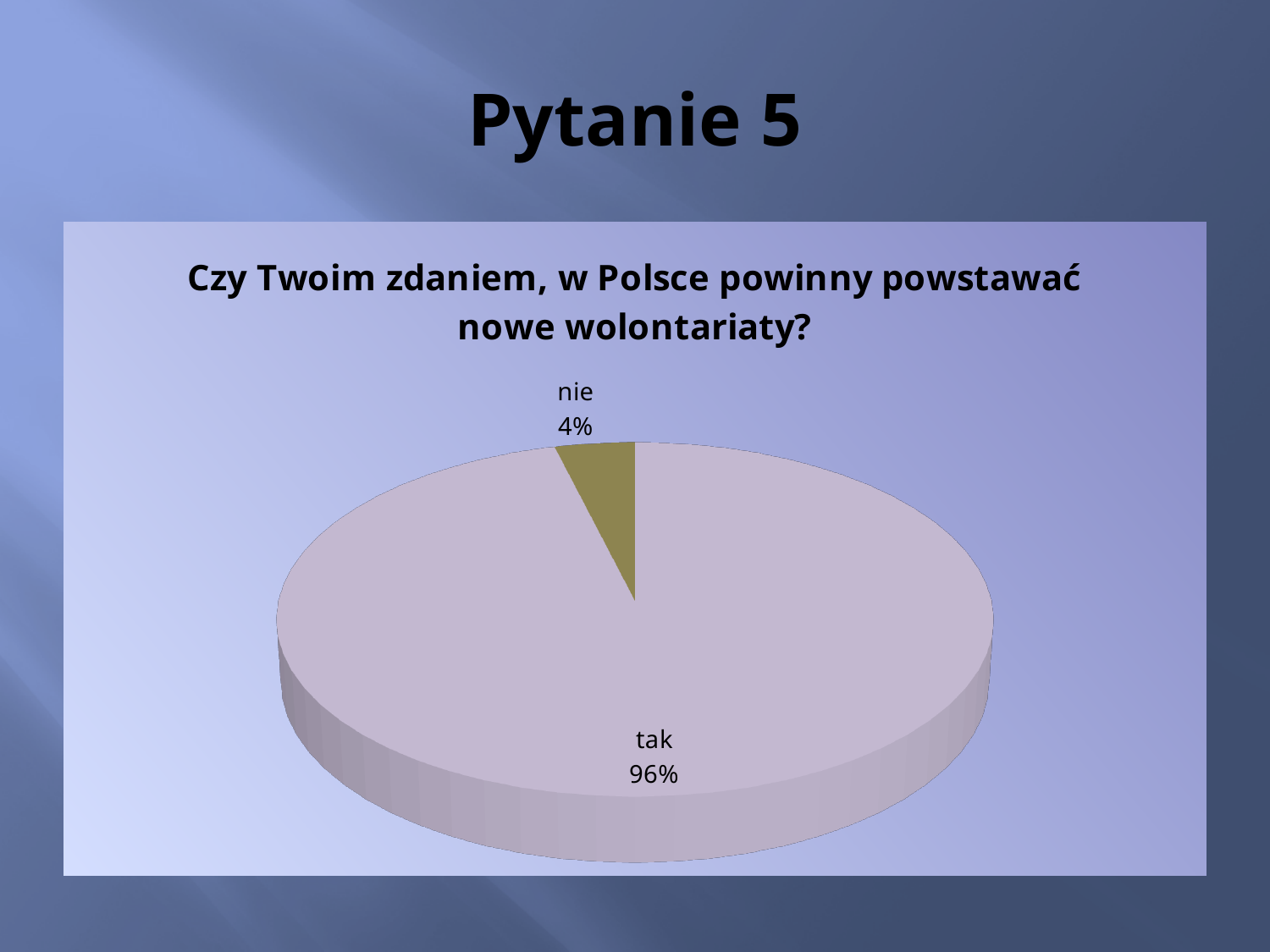
What is the title of the chart? Czy Twoim zdaniem, w Polsce powinny powstawać nowe wolontariaty? What percentage of respondents answered "tak"? 96% What percentage of respondents answered "nie"? 4% What kind of chart is shown on the slide? pie chart What share of the pie does the "nie" slice represent? 4% Which answer has the smallest share of the pie? nie How many slices does the pie chart have? 2 Which answer has the largest share of the pie? tak What is the difference in percentage points between the "tak" and "nie" shares? 92 Which is larger, the share for "tak" or the share for "nie"? tak What colour is the "nie" slice? olive/gold